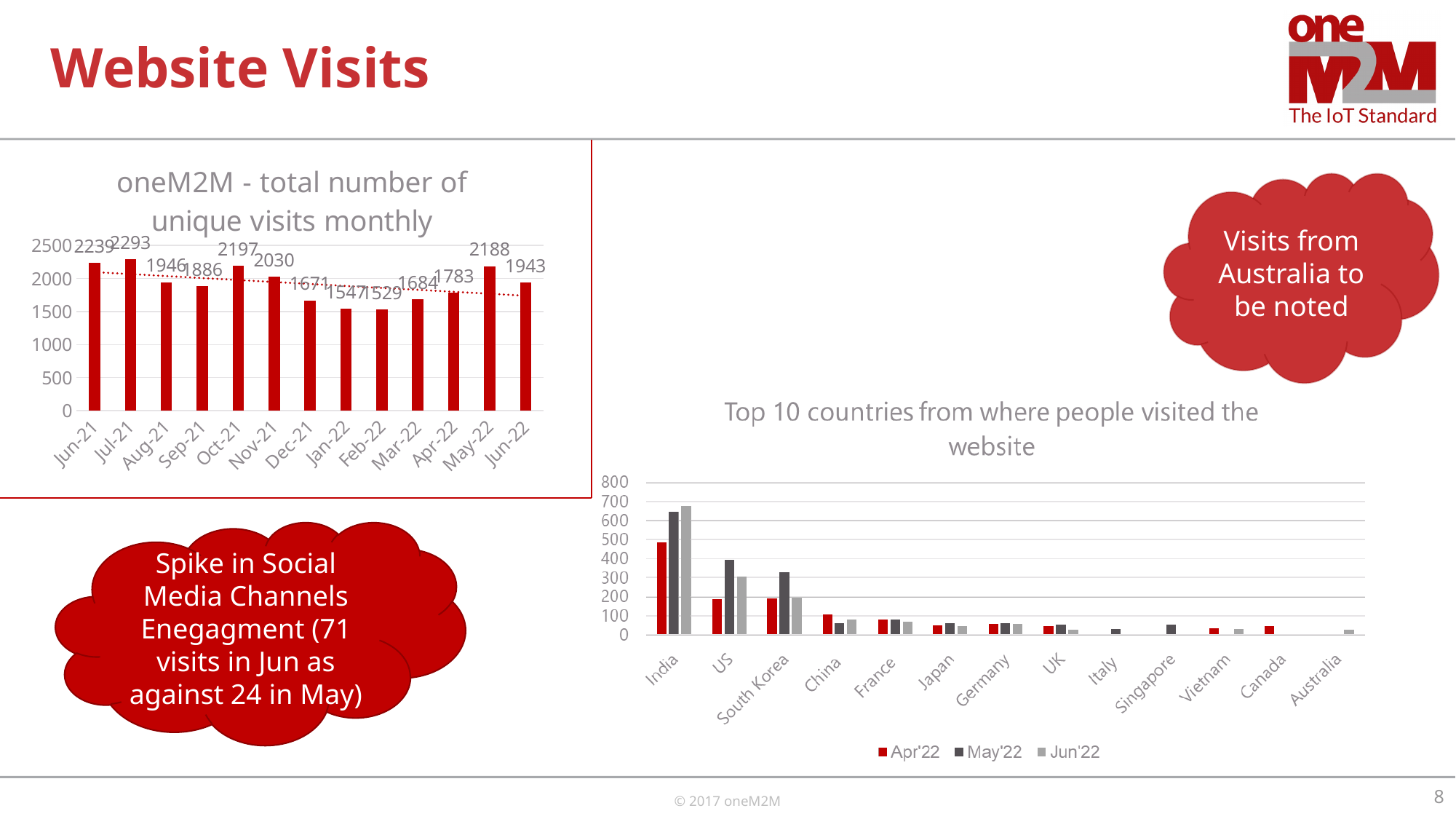
In the chart 'oneM2M - total number of unique visits monthly', what is the value for Jul-21? 2293 In the chart 'Top 10 countries from where people visited the website', which is larger for May'22, India or US? India In the chart 'oneM2M - total number of unique visits monthly', which is larger, Oct-21 or Nov-21? Oct-21 How many months are shown in the chart 'oneM2M - total number of unique visits monthly'? 13 In the chart 'oneM2M - total number of unique visits monthly', what is the difference between May-22 and Jun-22? 245 In the chart 'oneM2M - total number of unique visits monthly', what is the value for Feb-22? 1529 How many series does the legend list in the chart 'Top 10 countries from where people visited the website'? 3 What kind of chart is 'oneM2M - total number of unique visits monthly'? Bar chart In the chart 'oneM2M - total number of unique visits monthly', which month has the lowest value? Feb-22 In the chart 'oneM2M - total number of unique visits monthly', which month has the highest value? Jul-21 In the chart 'Top 10 countries from where people visited the website', is the Jun'22 value for India greater or less than 600? greater In the chart 'Top 10 countries from where people visited the website', which country has the highest Jun'22 value? India